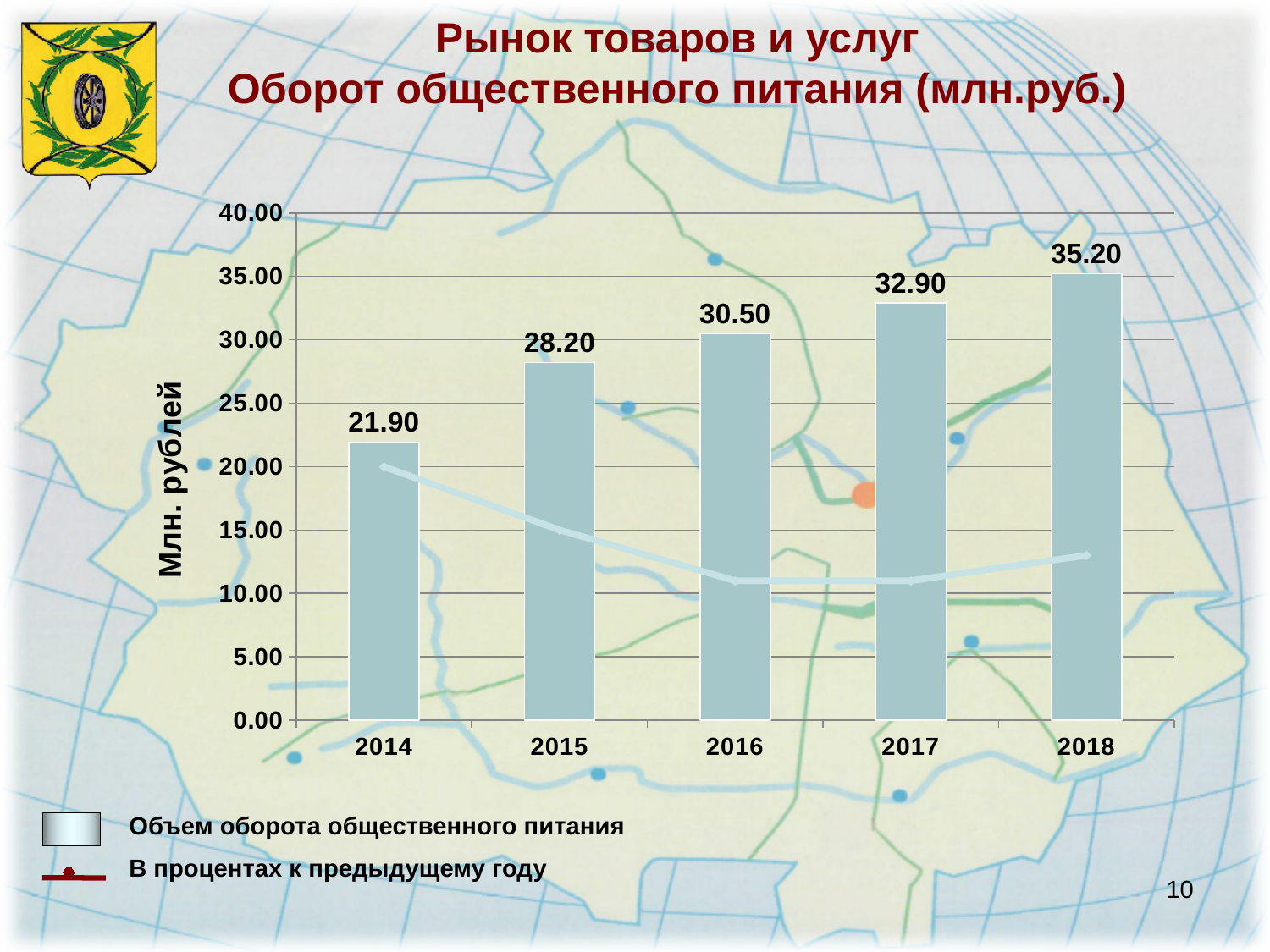
How many years are shown on the x axis? 5 What is the difference between the bar values for 2018 and 2014? 13.30 What is the difference between the bar values for 2015 and 2014? 6.30 Is the line value for 2016 greater or less than 15.00? less Which bar is larger, 2017 or 2015? 2017 Do the bar values rise or fall from 2014 to 2018? rise What is the value of the bar for 2014? 21.90 How many series does the legend list? 2 What is the value of the bar for 2018? 35.20 What is the value of the bar for 2016? 30.50 Which year has the lowest bar? 2014 Which year has the highest bar? 2018